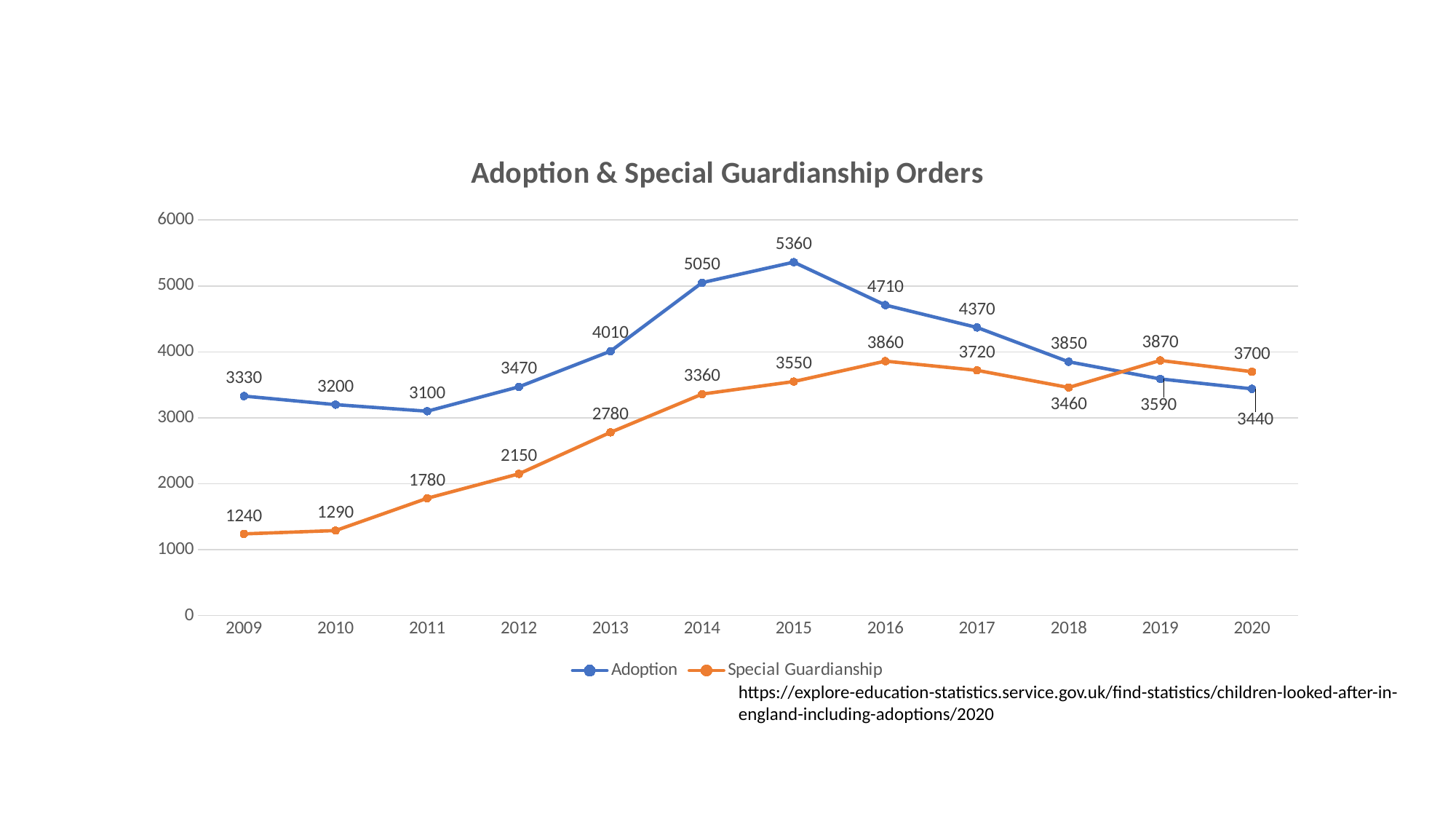
How many years are shown on the x axis? 12 In which year is the Adoption series highest? 2015 What is the Adoption value for 2015? 5360 What is the title of the chart? Adoption & Special Guardianship Orders What is the difference between the Adoption and Special Guardianship values in 2014? 1690 Is the Adoption value for 2013 greater or less than 4000? greater What is the Special Guardianship value for 2012? 2150 What kind of chart is shown? Line chart Which series has the larger value in 2019, Adoption or Special Guardianship? Special Guardianship How many series does the legend list? 2 Does the Special Guardianship series rise or fall from 2009 to 2016? Rise In which year is the Special Guardianship series lowest? 2009